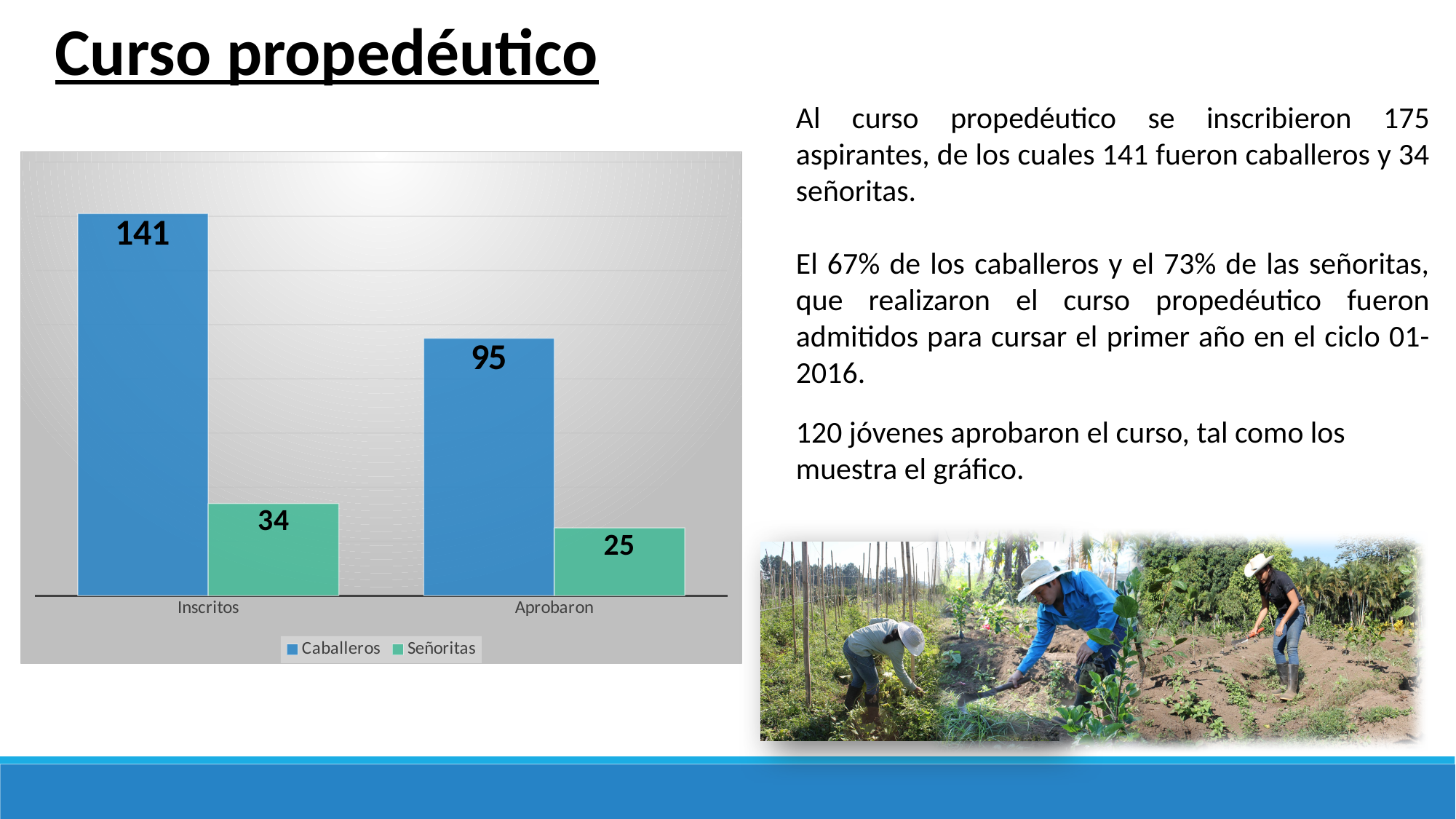
What is the value for Caballeros in the Aprobaron category? 95 What is the value for Señoritas in the Inscritos category? 34 Which bar has the lowest value on the chart? Señoritas, Aprobaron What is the difference between Caballeros Inscritos and Caballeros Aprobaron? 46 What is the value for Señoritas in the Aprobaron category? 25 Which is larger: Caballeros Aprobaron or Señoritas Inscritos? Caballeros Aprobaron Which bar has the highest value on the chart? Caballeros, Inscritos What is the value for Caballeros in the Inscritos category? 141 What is the difference between Señoritas Inscritos and Señoritas Aprobaron? 9 What kind of chart is shown on the slide? Bar chart How many categories are shown on the x axis? 2 How many series does the legend list? 2